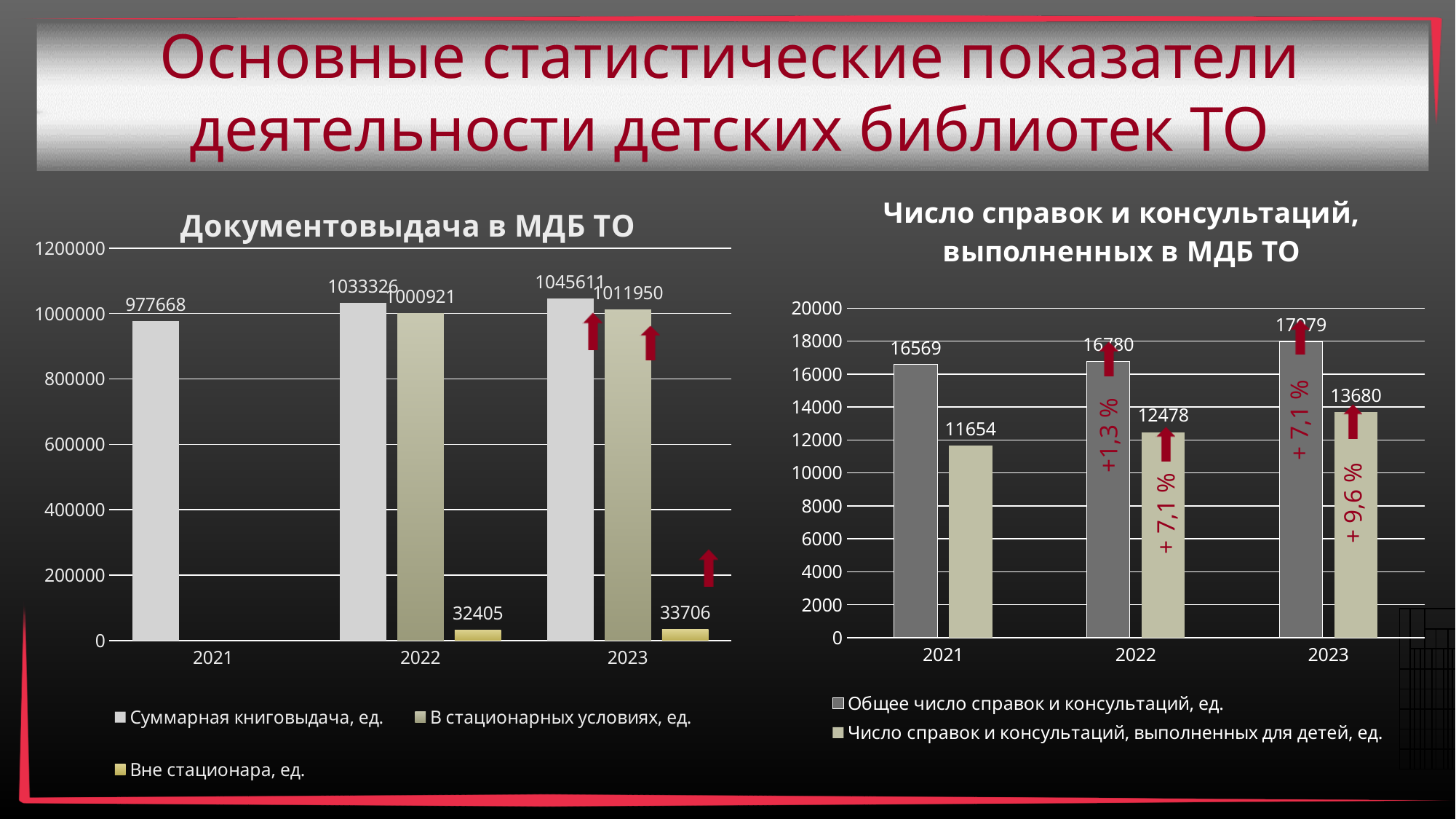
On the chart 'Число справок и консультаций, выполненных в МДБ ТО', what is the value of 'Общее число справок и консультаций, ед.' for 2021? 16569 On the chart 'Документовыдача в МДБ ТО', what is the difference between 'Суммарная книговыдача, ед.' in 2023 and in 2022? 12285 On the chart 'Число справок и консультаций, выполненных в МДБ ТО', is the value of 'Общее число справок и консультаций, ед.' for 2023 greater or less than 16000? greater On the chart 'Документовыдача в МДБ ТО', what is the value of 'В стационарных условиях, ед.' for 2023? 1011950 On the chart 'Документовыдача в МДБ ТО', how many series does the legend list? 3 On the chart 'Документовыдача в МДБ ТО', what is the value of 'Вне стационара, ед.' for 2022? 32405 On the chart 'Число справок и консультаций, выполненных в МДБ ТО', what is the difference between 'Число справок и консультаций, выполненных для детей, ед.' in 2022 and in 2021? 824 On the chart 'Документовыдача в МДБ ТО', does 'Суммарная книговыдача, ед.' rise or fall from 2021 to 2023? rise What kind of chart is 'Число справок и консультаций, выполненных в МДБ ТО'? bar chart On the chart 'Документовыдача в МДБ ТО', what is the value of 'Суммарная книговыдача, ед.' for 2021? 977668 On the chart 'Документовыдача в МДБ ТО', in which year is 'Суммарная книговыдача, ед.' highest? 2023 On the chart 'Число справок и консультаций, выполненных в МДБ ТО', what is the value of 'Число справок и консультаций, выполненных для детей, ед.' for 2023? 13680